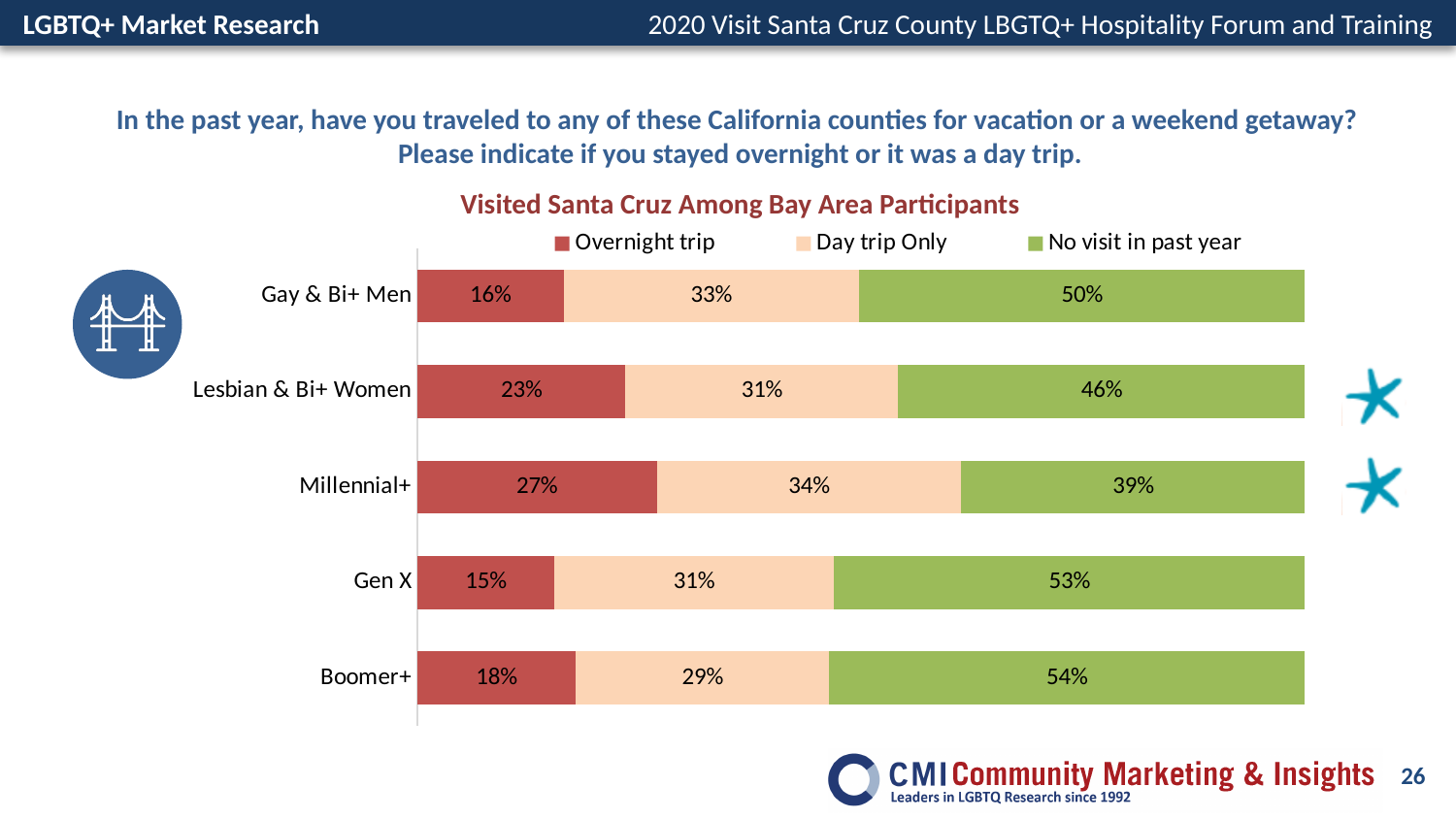
Which group has the highest 'Overnight trip' percentage? Millennial+ What is the difference between the 'No visit in past year' values for Gen X and Lesbian & Bi+ Women? 7% How many series does the legend list? 3 What type of chart is shown on the slide? Stacked bar chart What percentage of Gay & Bi+ Men took an overnight trip to Santa Cruz? 16% What is the 'Day trip Only' value for Boomer+? 29% How many groups are shown on the chart? 5 What is the 'No visit in past year' value for Millennial+? 39% What is the title of the chart? Visited Santa Cruz Among Bay Area Participants Which group has the highest 'No visit in past year' percentage? Boomer+ Which is larger: the 'Overnight trip' value for Lesbian & Bi+ Women or for Boomer+? Lesbian & Bi+ Women Which group has the lowest 'No visit in past year' percentage? Millennial+